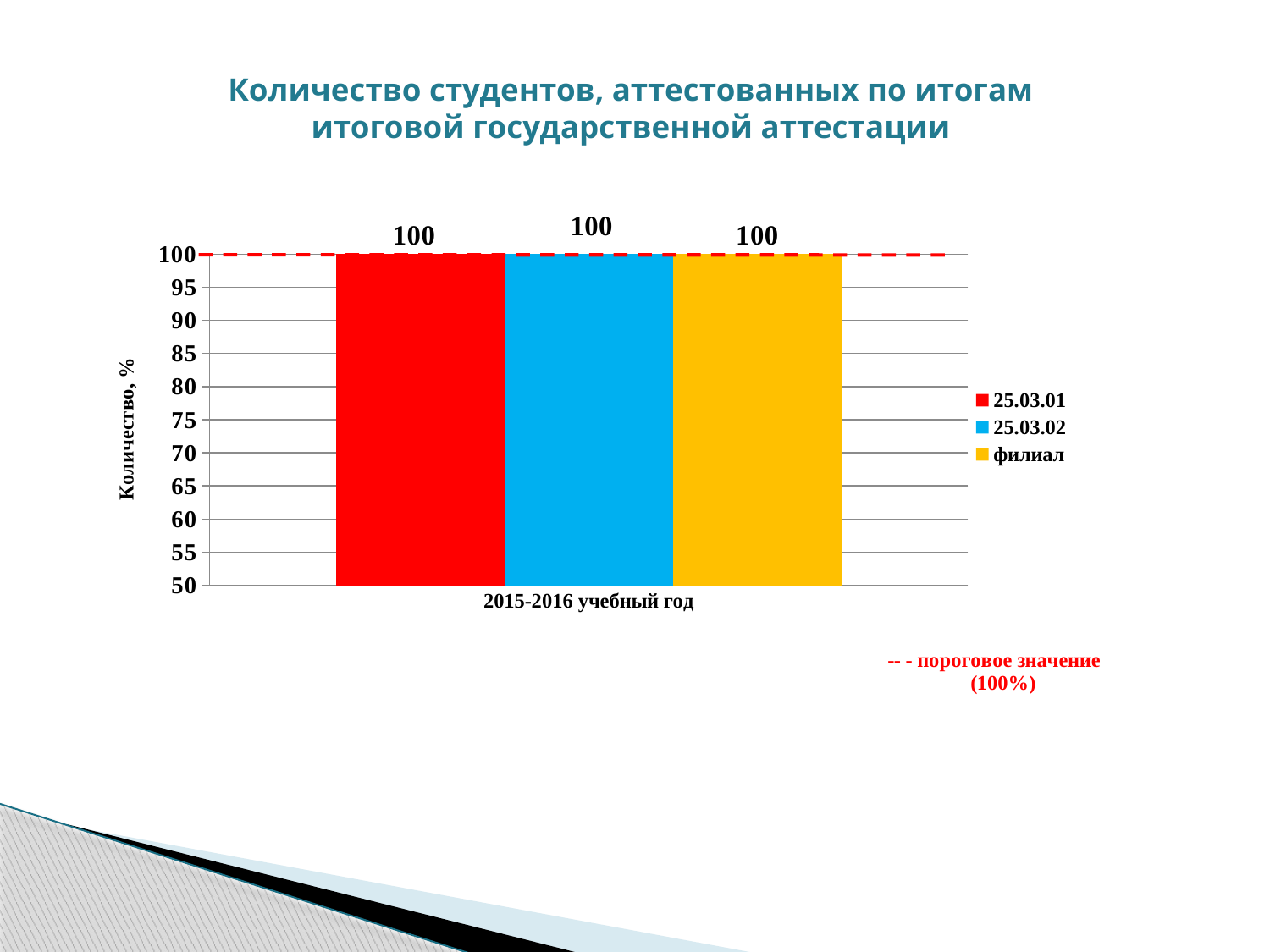
What kind of chart is shown on the slide? bar chart What colour is the bar for филиал? yellow How many series does the legend list? 3 What is the value for 25.03.01 in the 2015-2016 учебный год? 100 Is the value for 25.03.02 greater or less than 90? greater What is the label of the y axis? Количество, % What is the difference between the values for 25.03.01 and филиал? 0 What is the value for 25.03.02 in the 2015-2016 учебный год? 100 What is the value for филиал in the 2015-2016 учебный год? 100 How many categories are shown on the x axis? 1